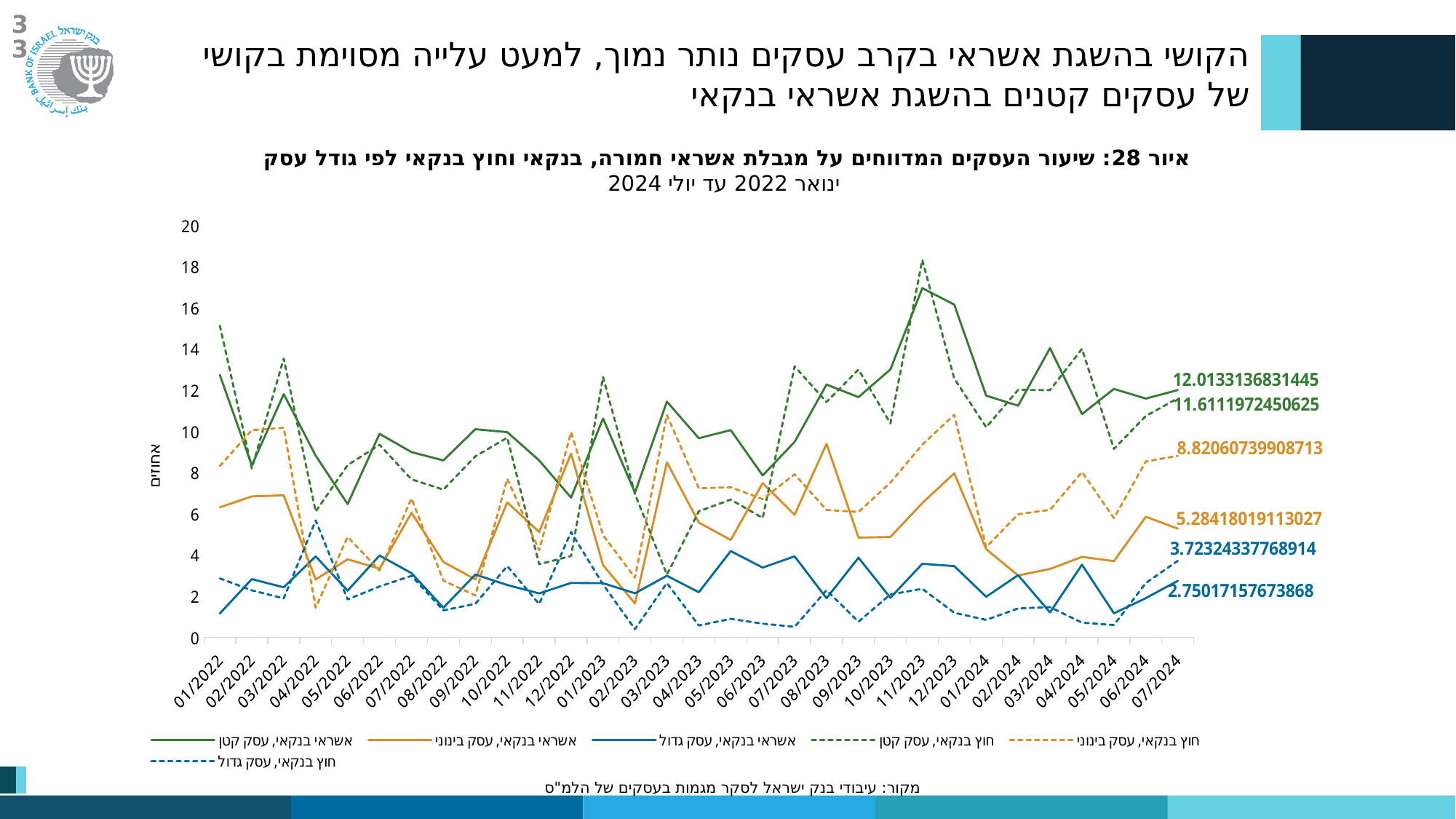
Which series has the lowest value at 07/2024? אשראי בנקאי, עסק גדול What is the value for חוץ בנקאי, עסק בינוני at 07/2024? 8.82060739908713 How many series does the legend list? 6 What is the label on the y axis? אחוזים How many monthly points are shown along the x axis? 31 Which series has the highest value at 07/2024? אשראי בנקאי, עסק קטן At 07/2024, which is larger: אשראי בנקאי, עסק בינוני or חוץ בנקאי, עסק בינוני? חוץ בנקאי, עסק בינוני What is the value for אשראי בנקאי, עסק גדול at 07/2024? 2.75017157673868 What kind of chart is shown on the slide? line chart Is the value for אשראי בנקאי, עסק קטן at 11/2023 greater or less than 16? greater What is the value for חוץ בנקאי, עסק גדול at 07/2024? 3.72324337768914 What is the value for אשראי בנקאי, עסק קטן at 07/2024? 12.0133136831445